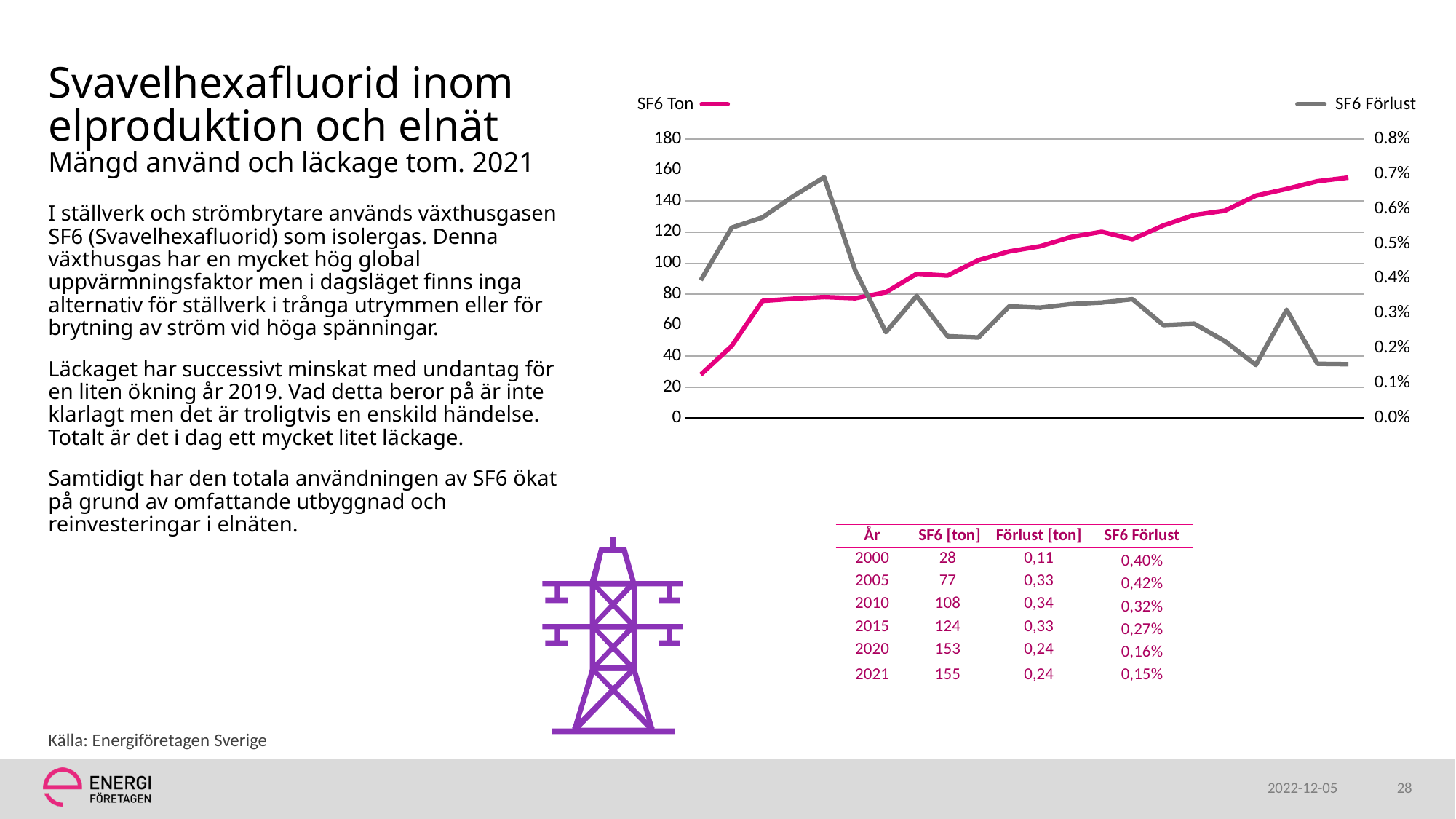
Does the SF6 Förlust line generally rise or fall from left to right? fall Does the SF6 Ton line generally rise or fall from left to right? rise What is the highest tick value shown on the chart's left vertical axis? 180 Is the last (rightmost) value of the SF6 Förlust line greater or less than 0.2%? less What kind of chart is shown on the slide? line chart What are the two series named in the chart's legend? SF6 Ton and SF6 Förlust Is the first (leftmost) value of the SF6 Ton line greater or less than 40? less Is the highest point of the SF6 Förlust line greater or less than 0.6%? greater How many series does the chart's legend list? 2